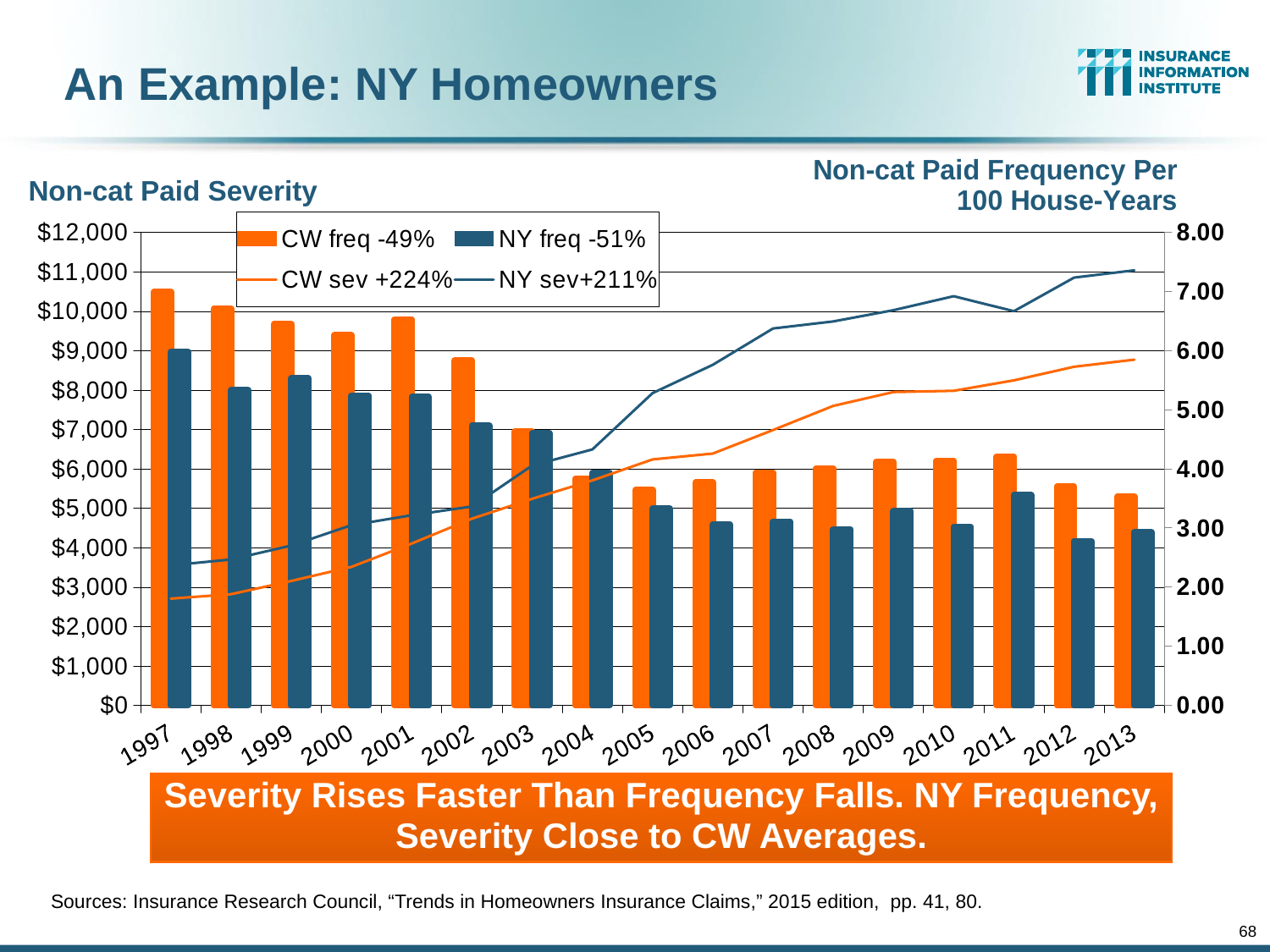
In 1997, which is larger, the CW freq bar or the NY freq bar? CW freq Is the NY sev value for 2013 greater or less than $10,000? greater How many years are shown along the x axis of the chart? 17 How many series does the chart's legend list? 4 Which year has the highest CW freq bar? 1997 Is the CW freq value for 1997 greater or less than 6.00? greater Is the CW sev value for 2013 greater or less than $9,000? less What is the title of the right-hand axis of the chart? Non-cat Paid Frequency Per 100 House-Years What kind of chart is shown on the slide? A combined bar and line chart Do the CW freq bars generally rise or fall from 1997 to 2013? Fall In which year does the NY sev line reach its highest point? 2013